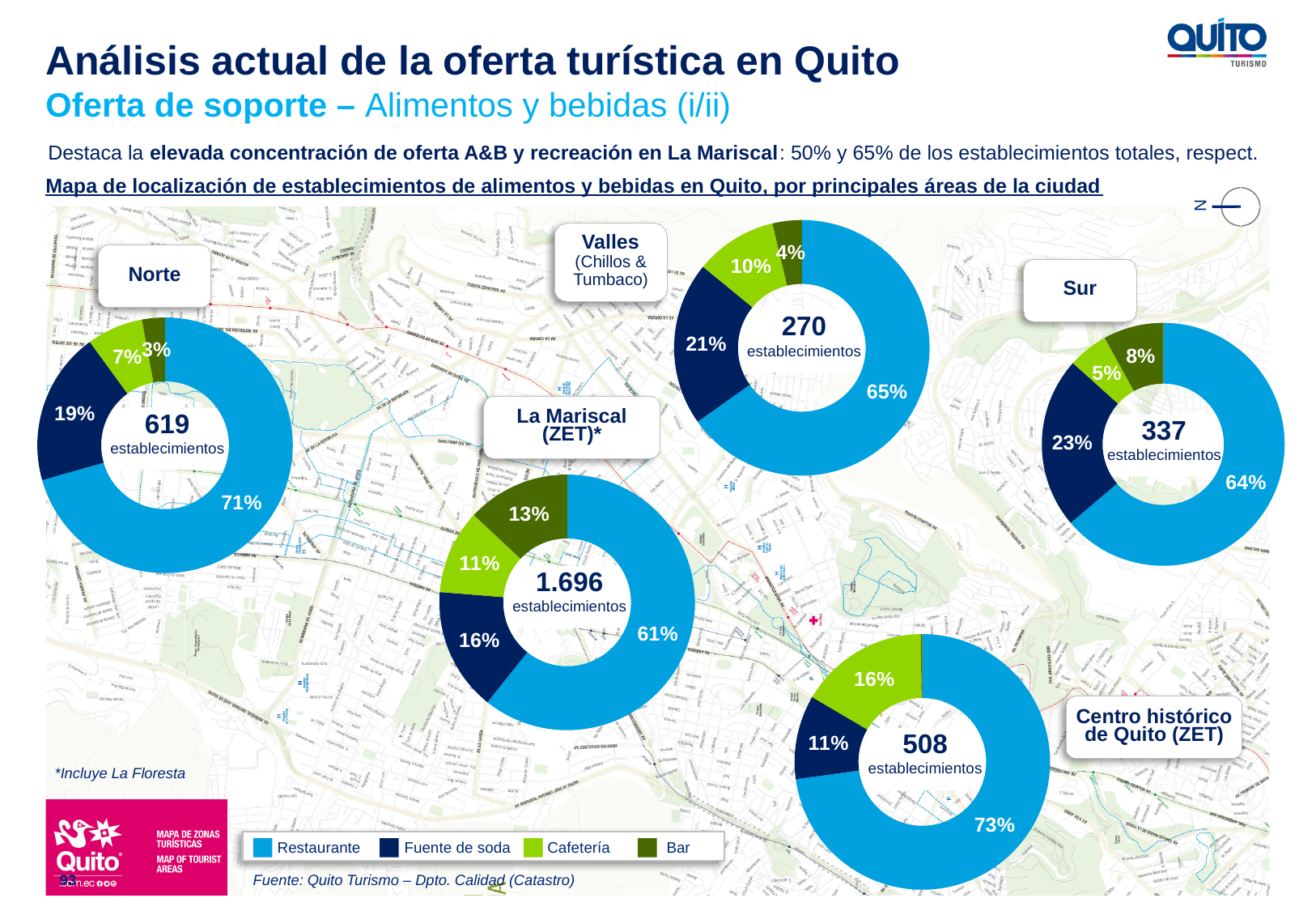
Which legend entry is shown in the darkest green colour? Bar In the Valles (Chillos & Tumbaco) chart, what percentage is shown for Cafetería? 10% Which area's chart has the smallest total number of establishments? Valles (Chillos & Tumbaco) Which area's chart has the largest total number of establishments? La Mariscal (ZET) Which is larger: the Bar share in the La Mariscal (ZET) chart or the Bar share in the Sur chart? La Mariscal (ZET) In the Centro histórico de Quito (ZET) chart, what percentage is shown for Restaurante? 73% What kind of chart is used for each area on the slide? Donut (pie) chart In the Sur chart, what percentage is shown for Fuente de soda? 23% In the La Mariscal (ZET) chart, what is the difference between the Restaurante share and the Fuente de soda share? 45% In the Norte chart, what share of establishments are Restaurante? 71% How many series does the legend list? 4 How many establishments does the La Mariscal (ZET) chart report in its centre? 1.696 establecimientos